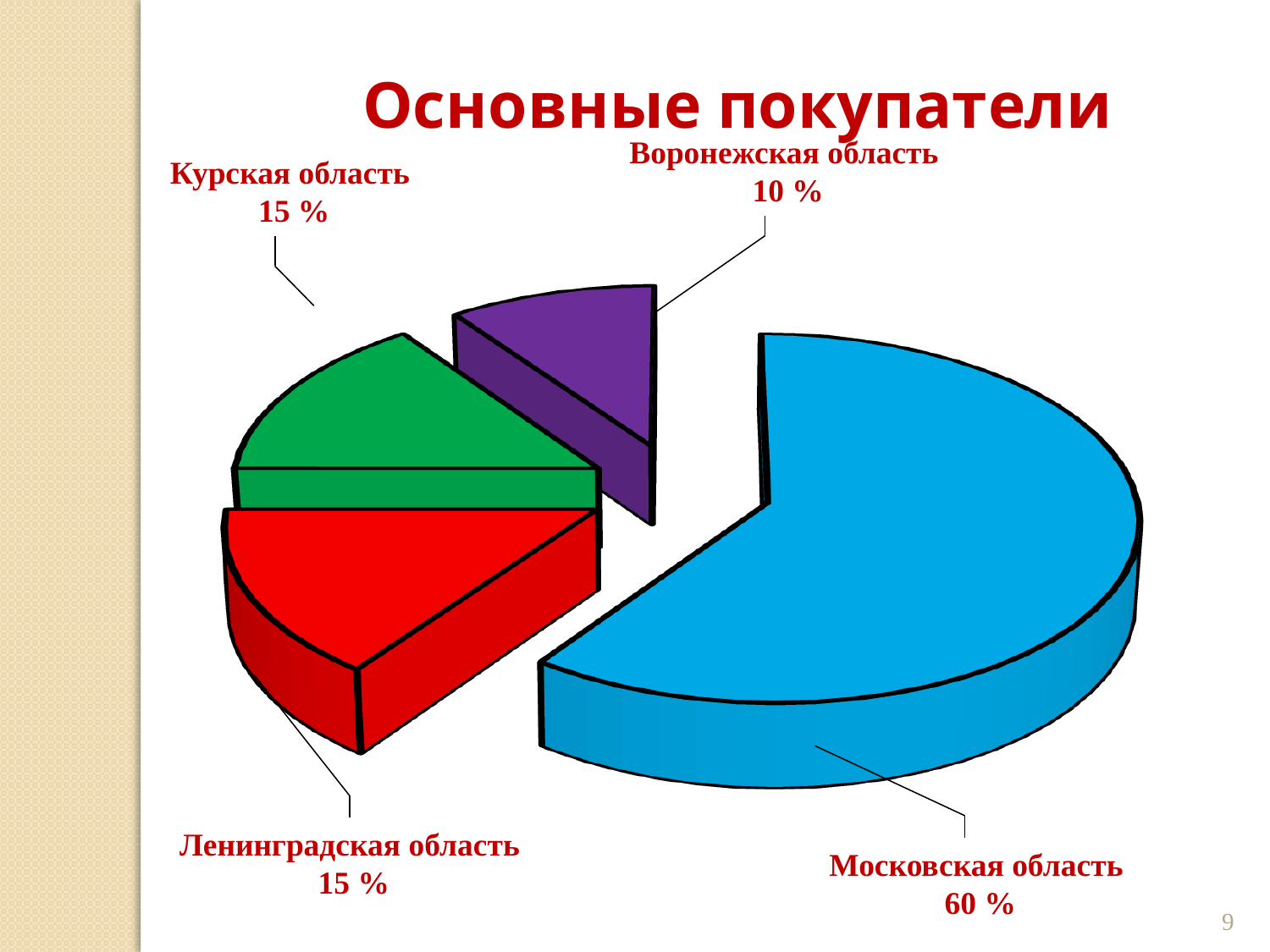
What kind of chart is shown on the slide? Pie chart What is the difference between the shares of Московская область and Воронежская область? 50 % Which is larger, the share of Московская область or the share of Ленинградская область? Московская область What share of the pie does Московская область have? 60 % What share of the pie does Воронежская область have? 10 % What share of the pie does Курская область have? 15 % Which region has the smallest share of the pie? Воронежская область What share of the pie does Ленинградская область have? 15 % What is the title of the chart? Основные покупатели Which region has the largest share of the pie? Московская область What is the difference between the shares of Курская область and Воронежская область? 5 % How many regions are shown in the pie chart? 4